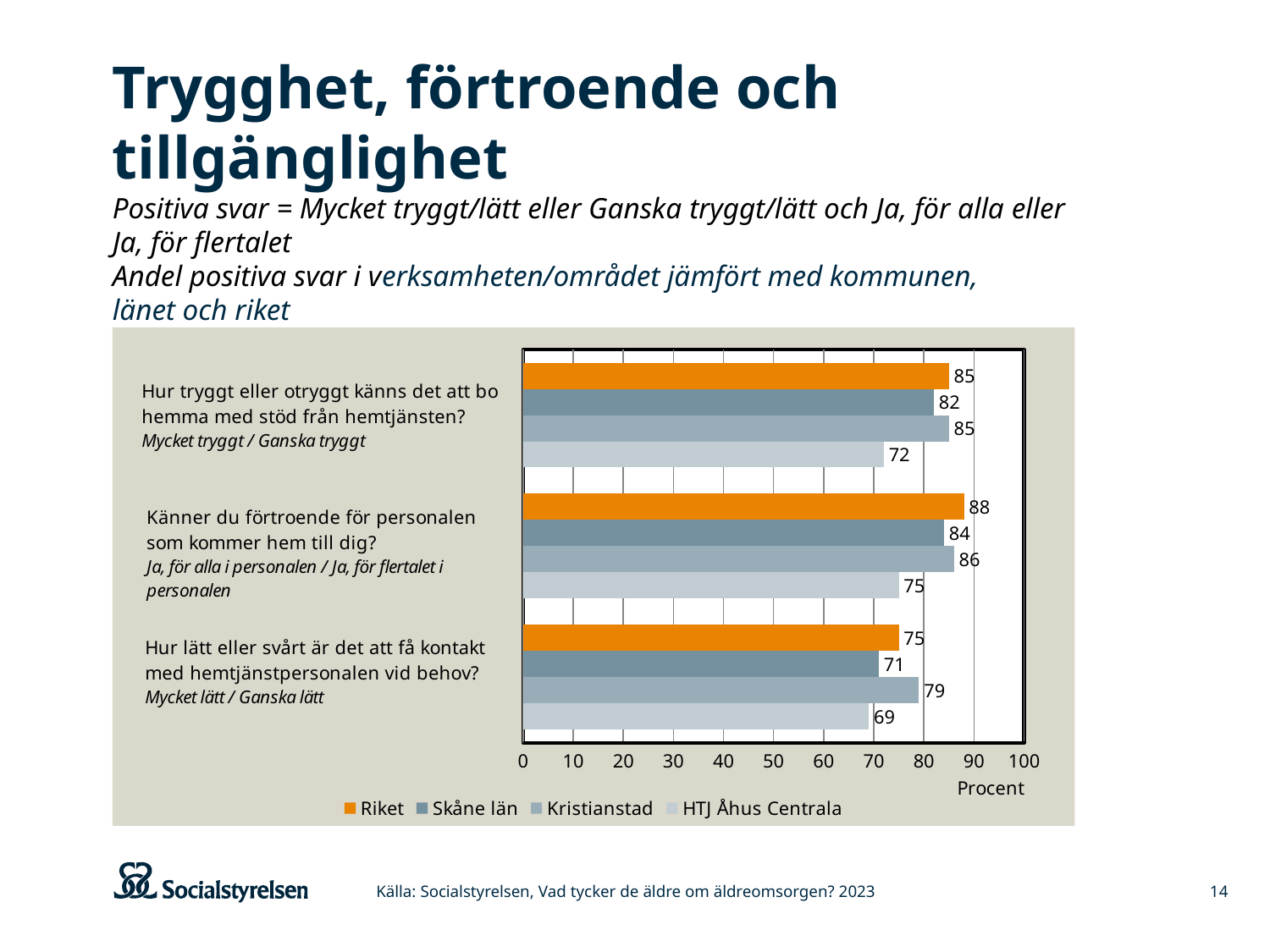
What is the difference between Riket and HTJ Åhus Centrala on the question "Känner du förtroende för personalen som kommer hem till dig?"? 13 What kind of chart is shown on the slide? Bar chart What is the value for Kristianstad on the question "Hur lätt eller svårt är det att få kontakt med hemtjänstpersonalen vid behov?"? 79 What is the value for Riket on the question "Känner du förtroende för personalen som kommer hem till dig?"? 88 What is the value for HTJ Åhus Centrala on the question "Hur tryggt eller otryggt känns det att bo hemma med stöd från hemtjänsten?"? 72 Which series has the lowest value on the question "Hur lätt eller svårt är det att få kontakt med hemtjänstpersonalen vid behov?"? HTJ Åhus Centrala What is the label on the horizontal axis of the chart? Procent How many question categories are shown on the chart? 3 What is the value for Skåne län on the question "Hur tryggt eller otryggt känns det att bo hemma med stöd från hemtjänsten?"? 82 How many series does the legend list? 4 Which is larger on the question "Hur lätt eller svårt är det att få kontakt med hemtjänstpersonalen vid behov?": Kristianstad or Riket? Kristianstad Which series has the highest value on the question "Känner du förtroende för personalen som kommer hem till dig?"? Riket